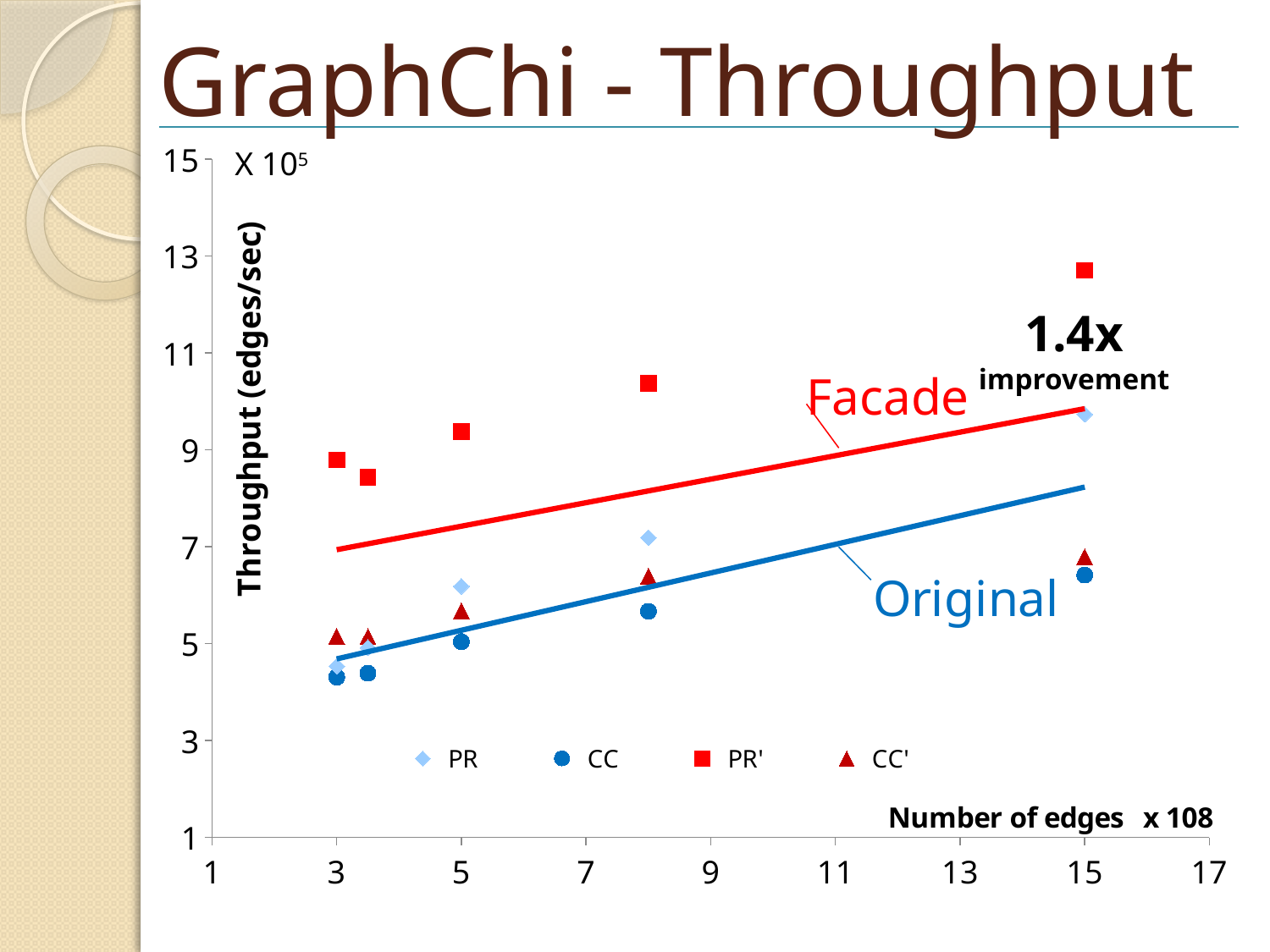
Do the PR' values generally rise or fall as the number of edges increases? rise Is the PR' value at 15 on the x axis greater or less than 11? greater At 15 on the x axis, which is larger, the PR' value or the CC value? PR' Is the CC' value at 15 on the x axis greater or less than 5? greater What is the title of the chart? GraphChi - Throughput How many series does the legend list? 4 Is the PR value at 15 on the x axis greater or less than 9? greater What is the label on the y axis? Throughput (edges/sec) What kind of chart is shown on the slide? scatter chart Which series contains the highest plotted point on the chart? PR'